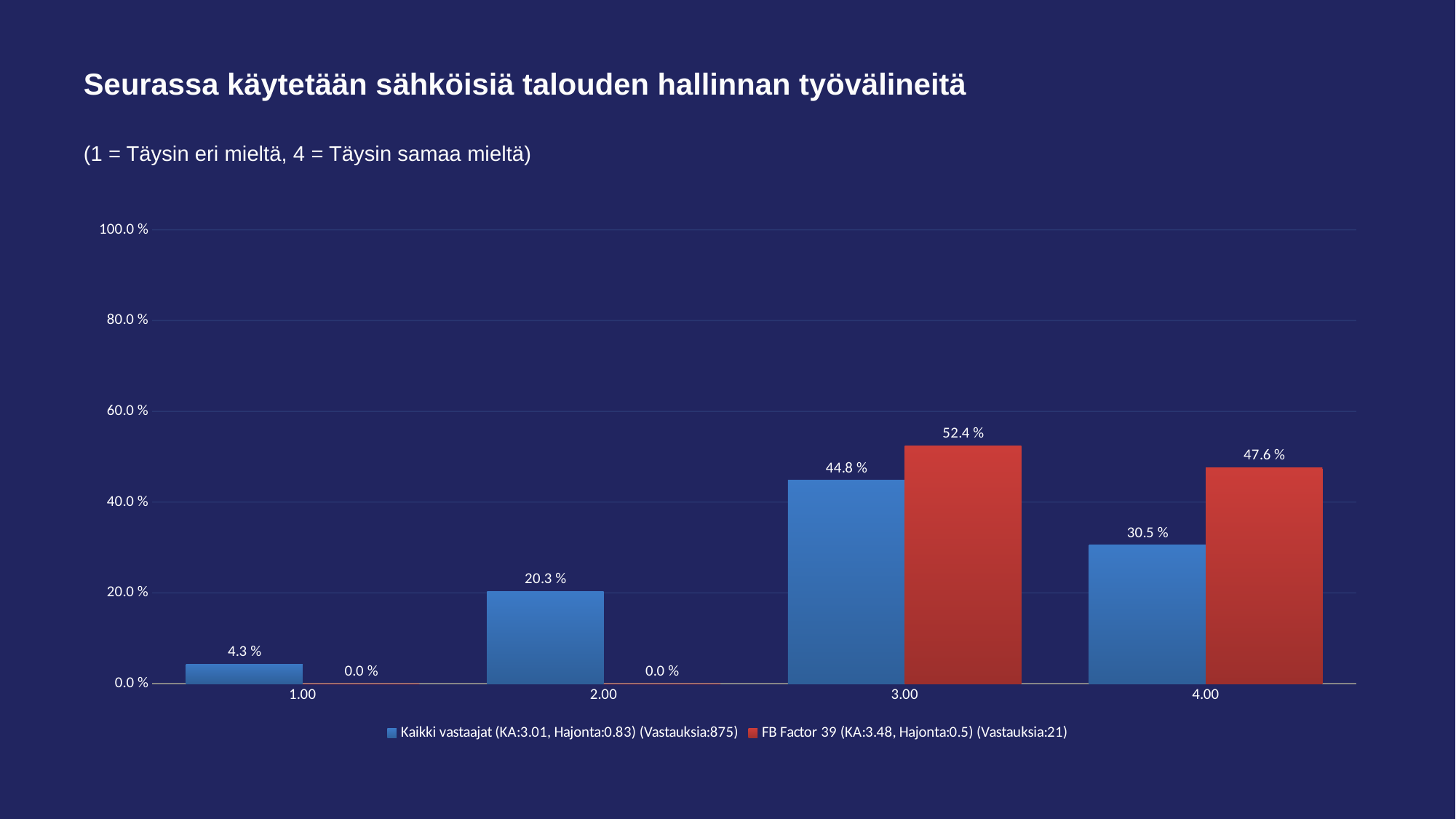
What is the value for Kaikki vastaajat at category 3.00? 44.8 % What is the difference between the FB Factor 39 and Kaikki vastaajat values at category 4.00? 17.1 % What is the value for Kaikki vastaajat at category 1.00? 4.3 % At category 3.00, which series has the larger value, Kaikki vastaajat or FB Factor 39? FB Factor 39 Which category has the lowest value for the Kaikki vastaajat series? 1.00 What is the title of the chart? Seurassa käytetään sähköisiä talouden hallinnan työvälineitä How many series does the legend list? 2 What kind of chart is shown on the slide? Bar chart What is the value for FB Factor 39 at category 2.00? 0.0 % How many categories are shown on the x axis? 4 What is the value for FB Factor 39 at category 4.00? 47.6 % Which category has the highest value for the FB Factor 39 series? 3.00